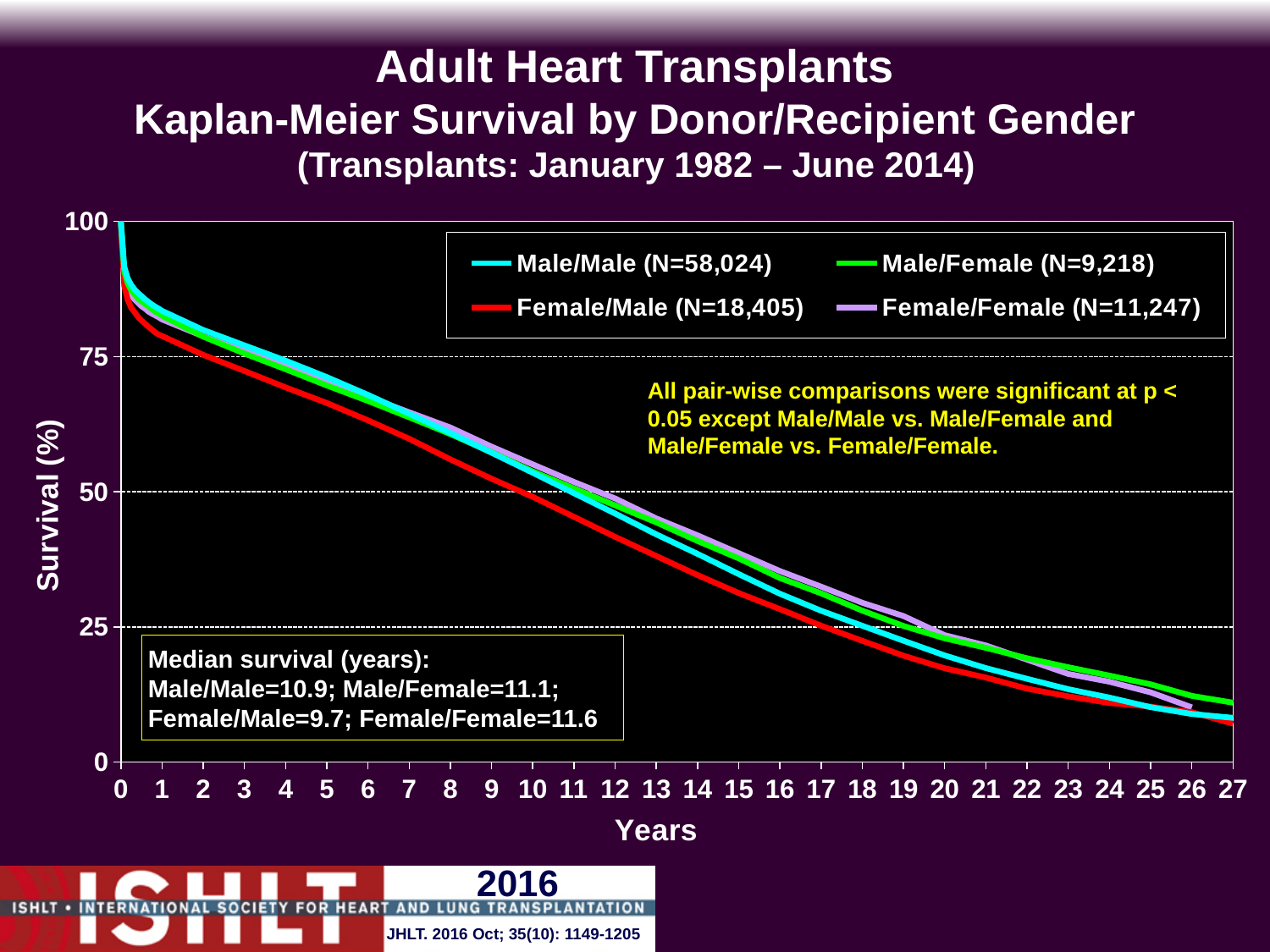
What is the difference in median survival (years) between Female/Female and Male/Male? 0.7 Which donor/recipient gender group has the highest median survival? Female/Female Which has the larger median survival, Male/Male or Male/Female? Male/Female Which donor/recipient gender group has the lowest median survival? Female/Male Is the survival value for the Female/Male group at 20 years greater or less than 25%? less Do the survival curves rise or fall as years increase? fall What is the median survival in years for the Female/Male group? 9.7 What kind of chart is shown on the slide? line chart How many series does the legend list? 4 What is the N for the Female/Female group shown in the legend? 11,247 What is the N for the Male/Male group shown in the legend? 58,024 What is the label of the y axis? Survival (%)